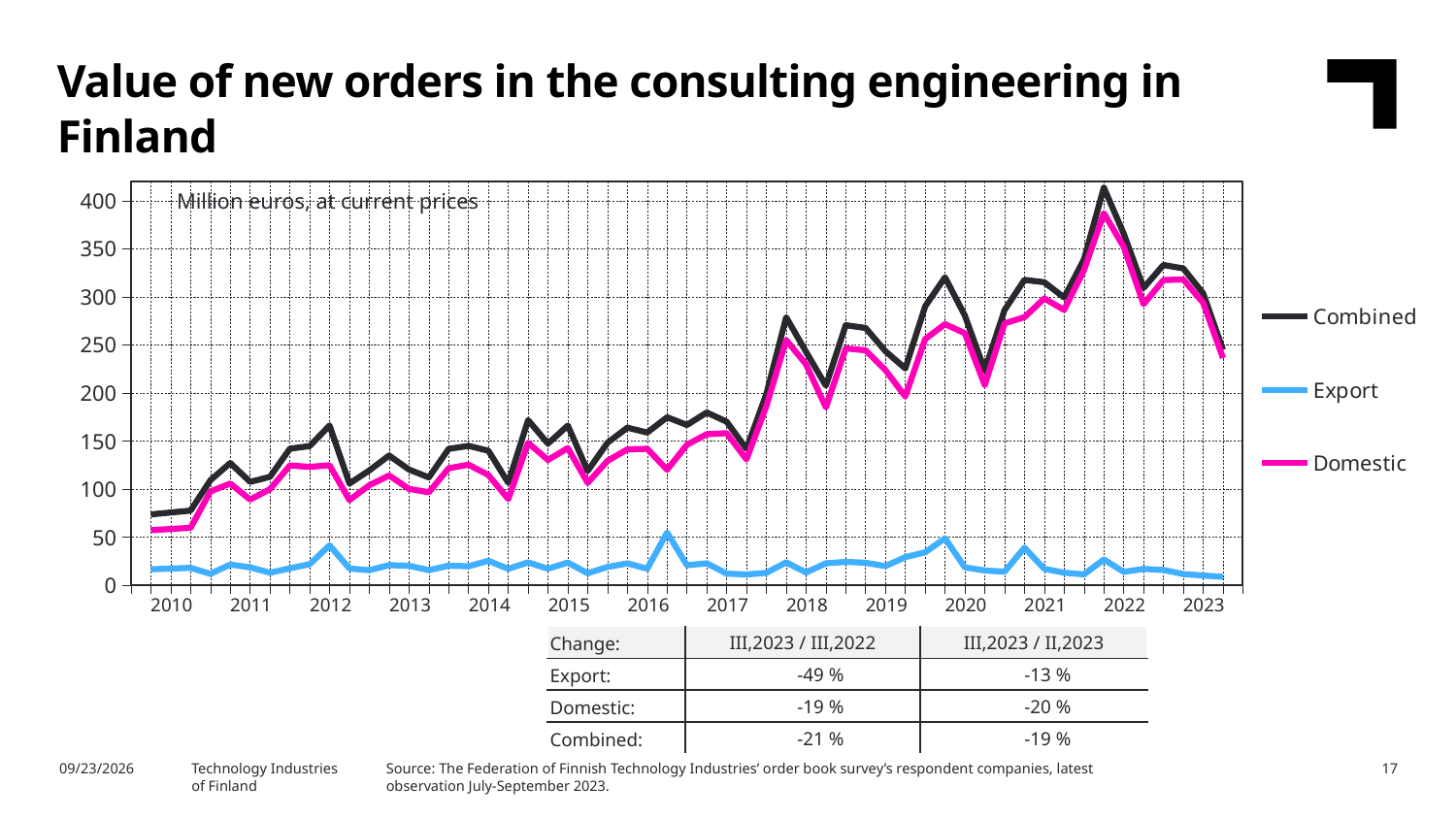
Which is larger at the last point in 2023, the Combined value or the Export value? Combined What unit is stated in the text at the top of the chart area? Million euros, at current prices Is the Combined value at the start of 2010 greater or less than 100? less What kind of chart is shown on the slide? line chart Which series reaches the highest value on the chart? Combined How many series does the legend list? 3 Is the Domestic value at the last point in 2023 greater or less than 200? greater Which series has the lowest values throughout the chart? Export How many years are labeled on the x axis? 14 What are the three series named in the legend? Combined, Export, Domestic Is the Export value at the start of 2010 greater or less than 50? less Does the Combined series generally rise or fall from 2010 to 2022? rise